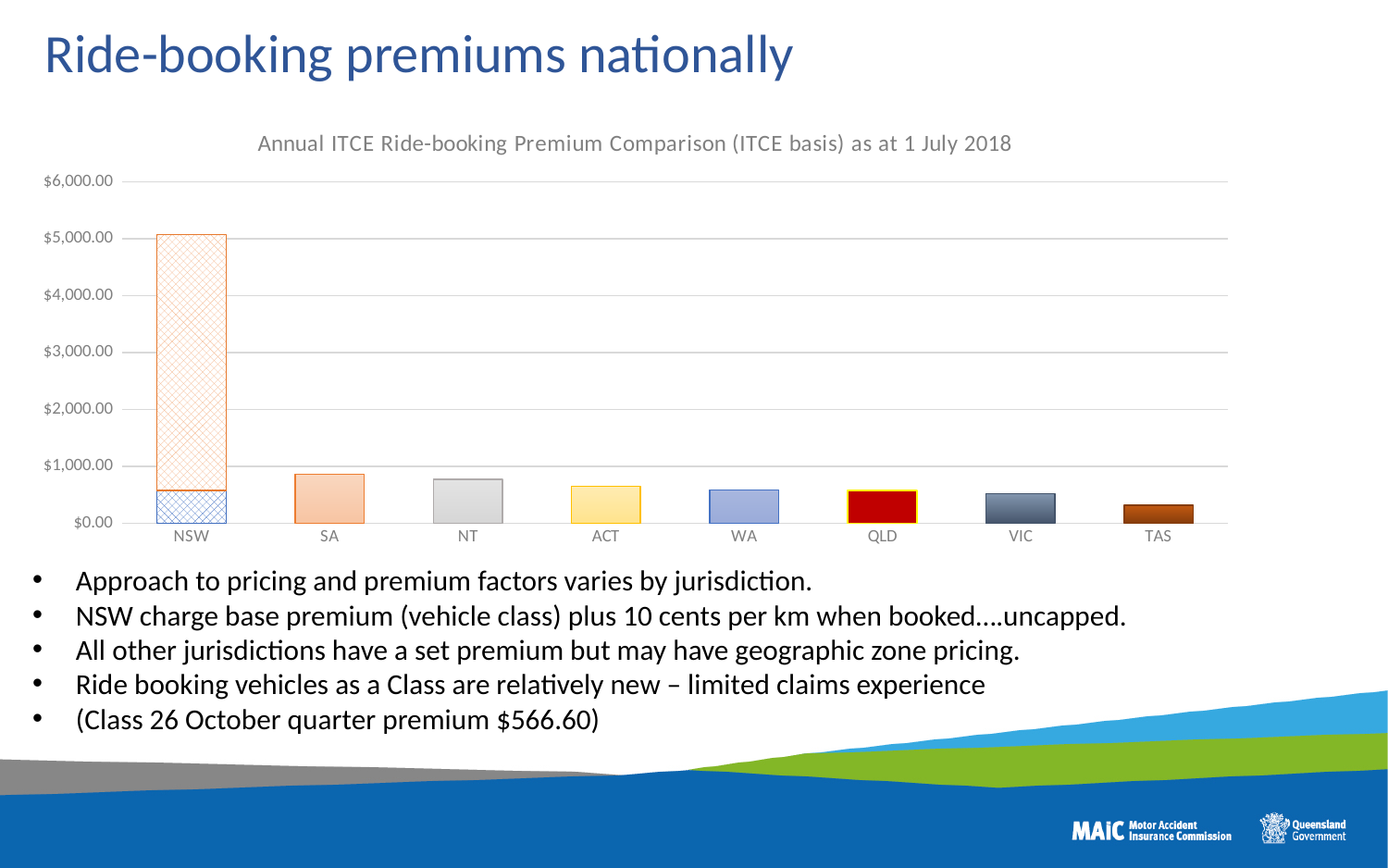
Which is larger, the value for NT or the value for ACT? NT Is the value for TAS greater or less than $1,000.00? less How many jurisdictions are shown on the x axis of the chart? 8 Is the value for SA greater or less than $1,000.00? less Which jurisdiction has the highest annual ride-booking premium in the chart? NSW Is the value for NSW greater or less than $4,000.00? greater What kind of chart is shown on the slide? Bar chart What is the title of the chart? Annual ITCE Ride-booking Premium Comparison (ITCE basis) as at 1 July 2018 Which is larger, the value for VIC or the value for TAS? VIC Which jurisdiction has the lowest annual ride-booking premium in the chart? TAS Do the premium values generally rise or fall moving from NSW on the left to TAS on the right? fall Which is larger, the value for SA or the value for TAS? SA